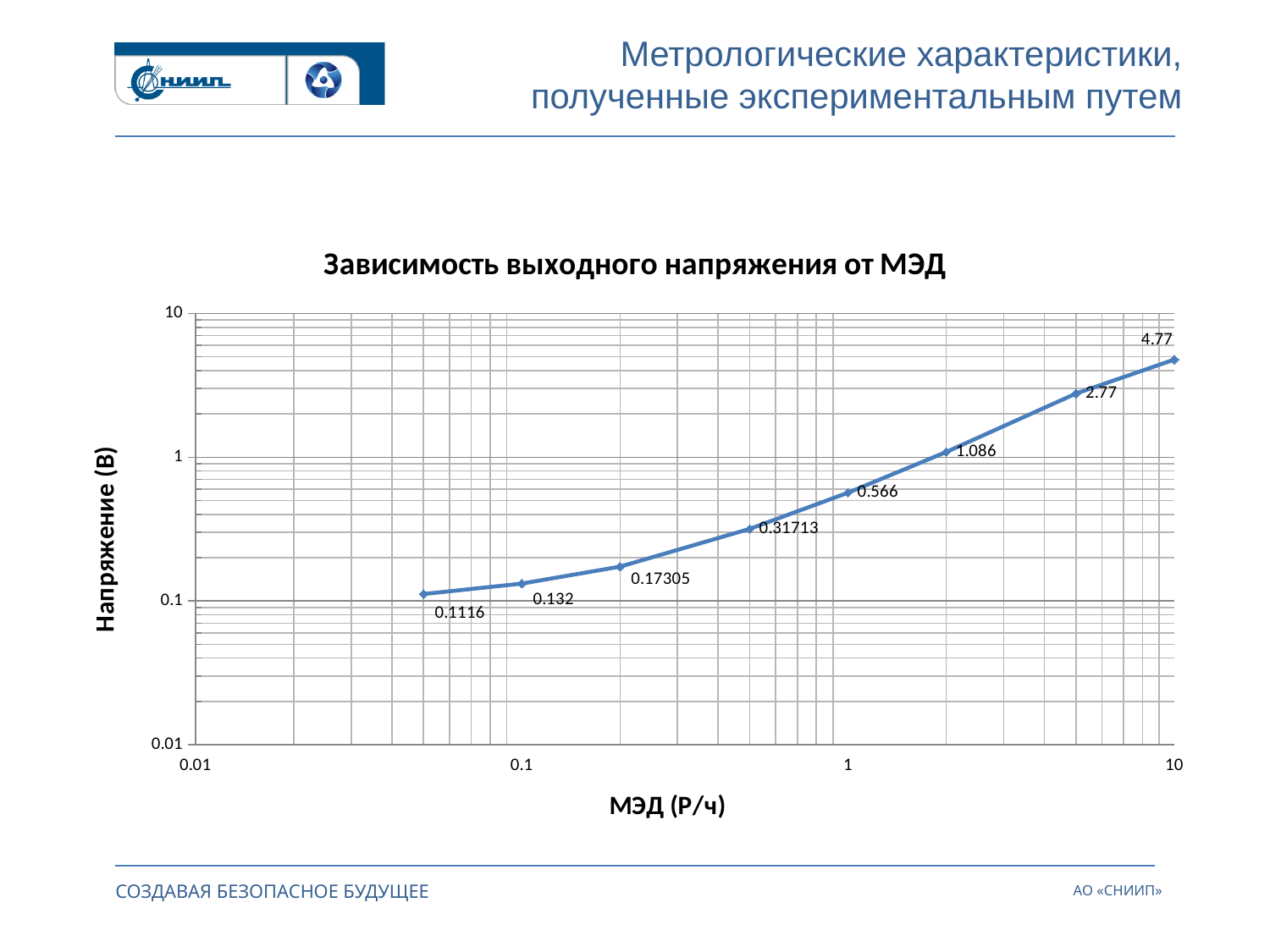
What is the output voltage at МЭД = 10 Р/ч? 4.77 Is the voltage at МЭД = 10 Р/ч greater or less than 1? greater What is the output voltage at МЭД = 1 Р/ч? 0.566 What kind of chart is shown on the slide? line chart Does the output voltage rise or fall as МЭД increases along the x axis? rises What is the output voltage at МЭД = 0.1 Р/ч? 0.132 What is the difference between the two highest labeled values, 4.77 and 2.77? 2 Which labeled value is larger: 0.31713 or 0.17305? 0.31713 What is the title of the chart? Зависимость выходного напряжения от МЭД What is the lowest labeled voltage value on the chart? 0.1116 How many data points are plotted on the chart? 8 What is the highest labeled voltage value on the chart? 4.77